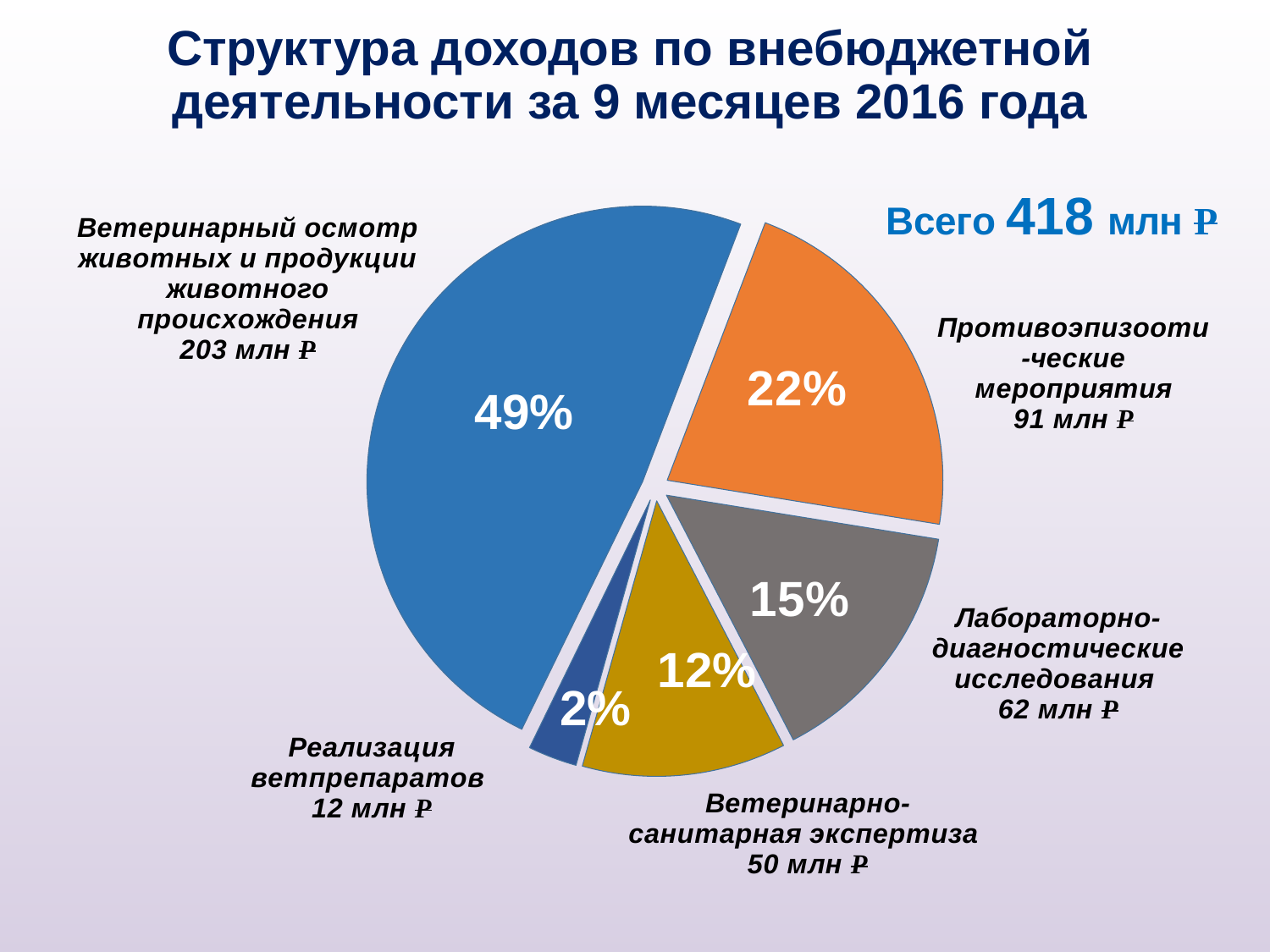
What is the value shown for "Ветеринарно-санитарная экспертиза"? 50 млн ₽ Which category has the largest share of the pie? Ветеринарный осмотр животных и продукции животного происхождения What share of the pie does "Противоэпизоотические мероприятия" take? 22% What share of the pie does "Ветеринарный осмотр животных и продукции животного происхождения" take? 49% What is the difference in млн ₽ between "Противоэпизоотические мероприятия" and "Лабораторно-диагностические исследования"? 29 млн ₽ Which category has the smallest share of the pie? Реализация ветпрепаратов What total amount is stated on the slide for all categories? 418 млн ₽ Which is larger: "Лабораторно-диагностические исследования" or "Ветеринарно-санитарная экспертиза"? Лабораторно-диагностические исследования How many slices does the pie chart have? 5 What share of the pie does "Лабораторно-диагностические исследования" take? 15% What is the value shown for "Реализация ветпрепаратов"? 12 млн ₽ What kind of chart is shown on the slide? Pie chart